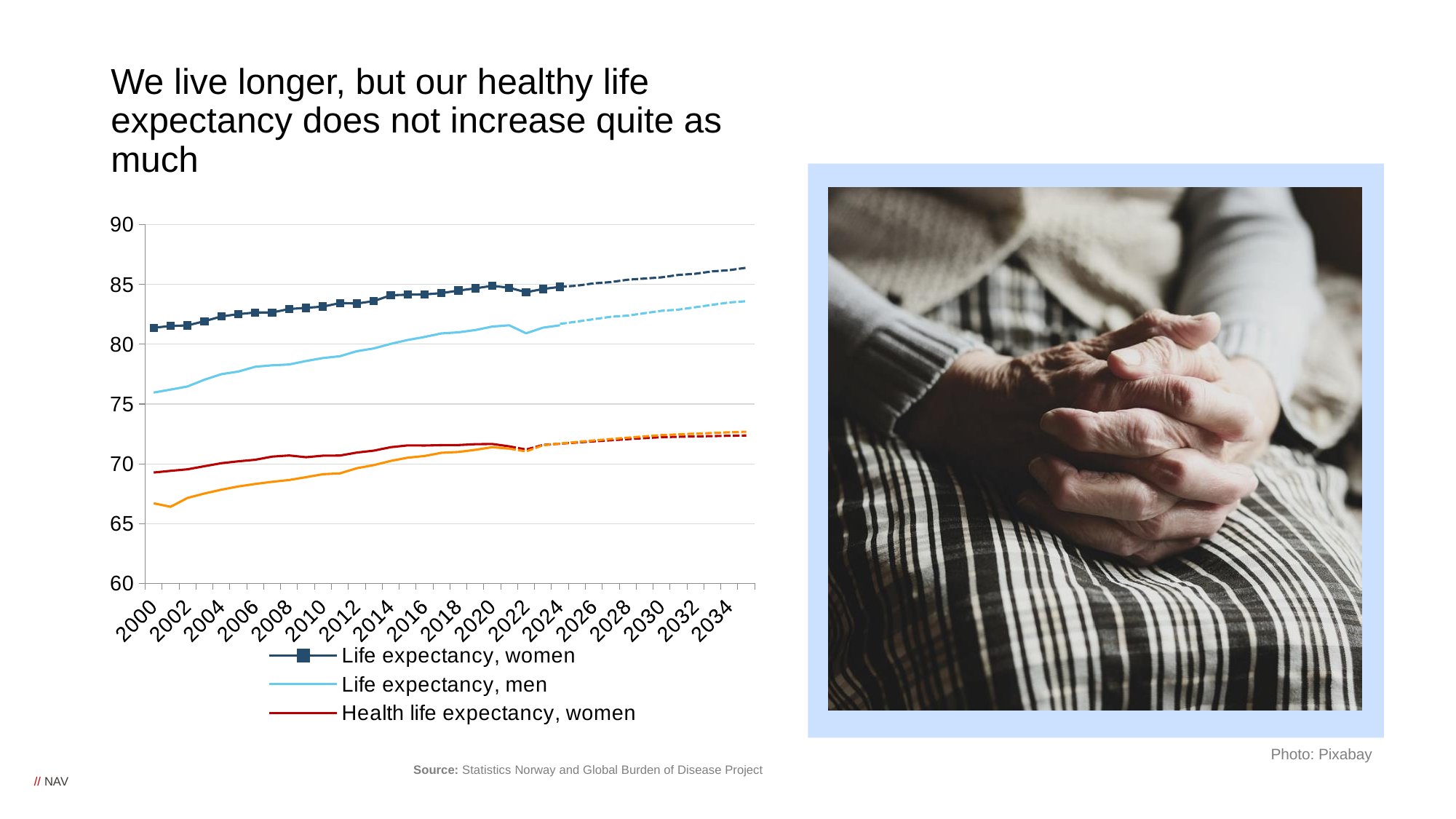
Is the value for Life expectancy, men in 2000 greater or less than 75? greater Is the value for Health life expectancy, women in 2000 greater or less than 70? less What kind of chart is shown on the slide? Line chart Is the value for Life expectancy, women in 2000 greater or less than 80? greater How many series does the chart's legend list? 3 Which series in the legend is drawn with square markers? Life expectancy, women Does Life expectancy, men generally rise or fall from 2000 to 2034? rise In 2010, which is larger: Life expectancy, women or Life expectancy, men? Life expectancy, women What is the first year shown on the x axis of the chart? 2000